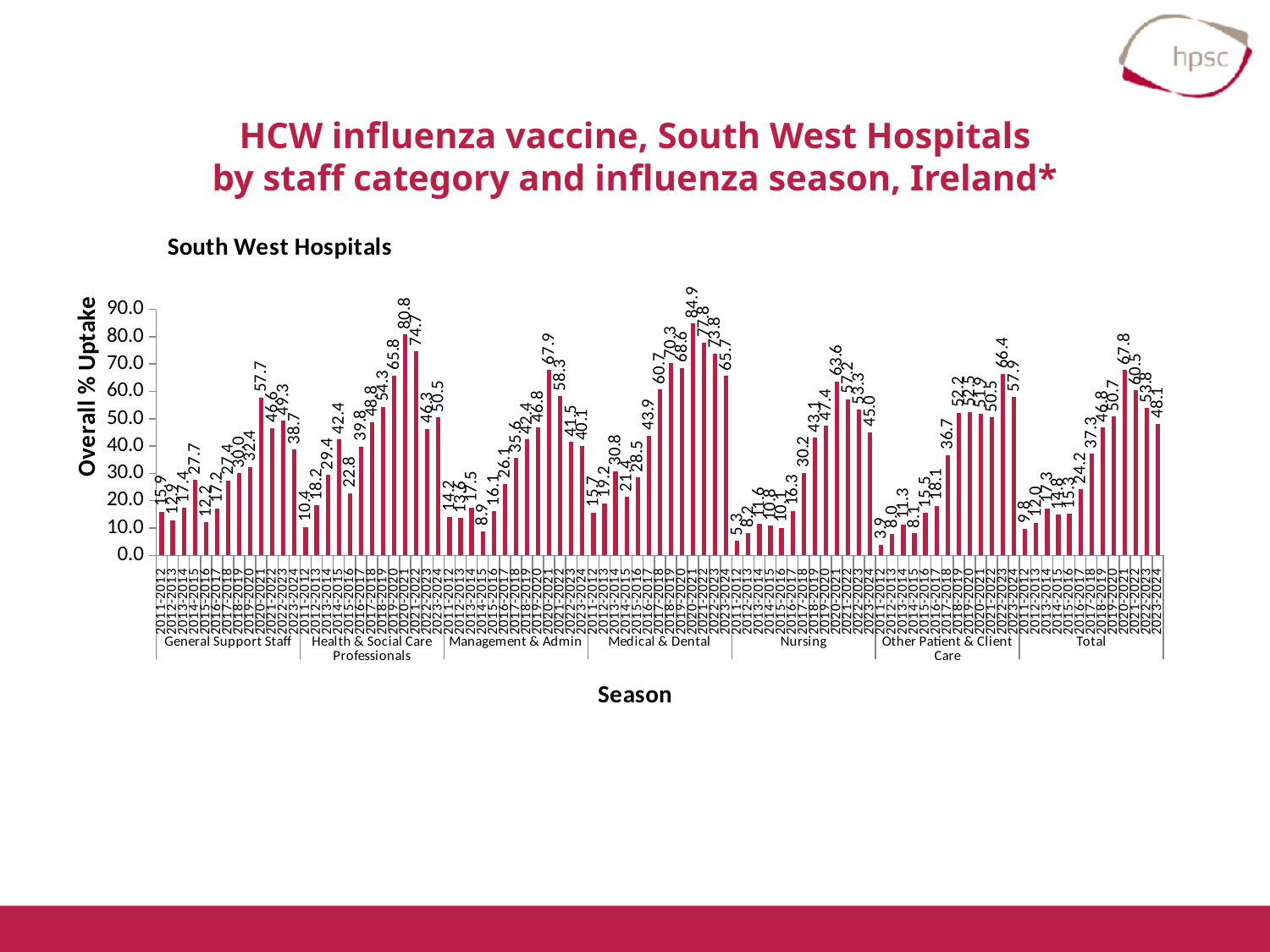
Which staff category and season has the highest overall % uptake on the chart? Medical & Dental, 2020-2021 In the 2020-2021 season, which has the higher uptake: Medical & Dental or Health & Social Care Professionals? Medical & Dental Is the Nursing uptake for the 2020-2021 season greater or less than 60? greater How many staff category groups are shown along the x axis? 7 What is the title of the vertical axis? Overall % Uptake What is the Total overall % uptake for the 2020-2021 season? 67.8 What is the overall % uptake for Medical & Dental staff in the 2020-2021 season? 84.9 What type of chart is shown on the slide? Bar chart What is the difference between the Total uptake in 2020-2021 and the Total uptake in 2023-2024? 19.7 Does the Total uptake rise or fall from the 2011-2012 season to the 2020-2021 season? Rise What is the overall % uptake for General Support Staff in the 2020-2021 season? 57.7 What is the overall % uptake for Health & Social Care Professionals in the 2020-2021 season? 80.8